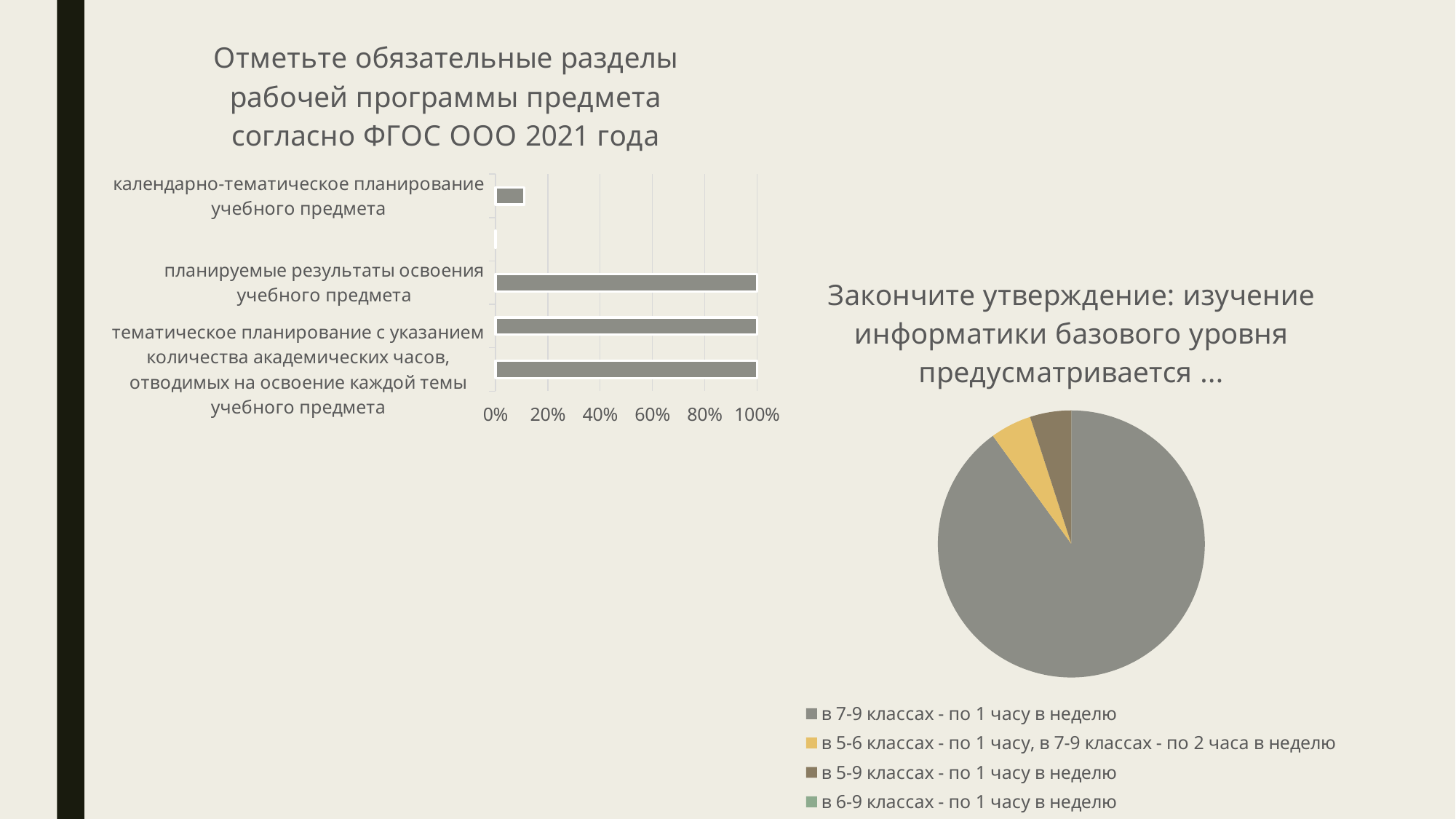
What kind of chart is the chart on the right, titled "Закончите утверждение: изучение информатики базового уровня предусматривается ..."? pie chart In the pie chart on the right, which slice is larger: "в 7-9 классах - по 1 часу в неделю" or "в 5-6 классах - по 1 часу, в 7-9 классах - по 2 часа в неделю"? в 7-9 классах - по 1 часу в неделю In the bar chart on the left, is the value for "планируемые результаты освоения учебного предмета" greater or less than 80%? greater In the pie chart on the right, what colour is the largest slice? gray What kind of chart is the chart on the left, titled "Отметьте обязательные разделы рабочей программы предмета согласно ФГОС ООО 2021 года"? bar chart In the pie chart on the right, which category has the largest slice? в 7-9 классах - по 1 часу в неделю In the bar chart on the left, what is the highest value shown on the horizontal axis? 100% In the bar chart on the left, is the value for "тематическое планирование с указанием количества академических часов, отводимых на освоение каждой темы учебного предмета" greater or less than 60%? greater In the bar chart on the left, is the value for "календарно-тематическое планирование учебного предмета" greater or less than 20%? less In the bar chart on the left, which has the larger value: "календарно-тематическое планирование учебного предмета" or "планируемые результаты освоения учебного предмета"? планируемые результаты освоения учебного предмета In the pie chart on the right, how many entries does the legend list? 4